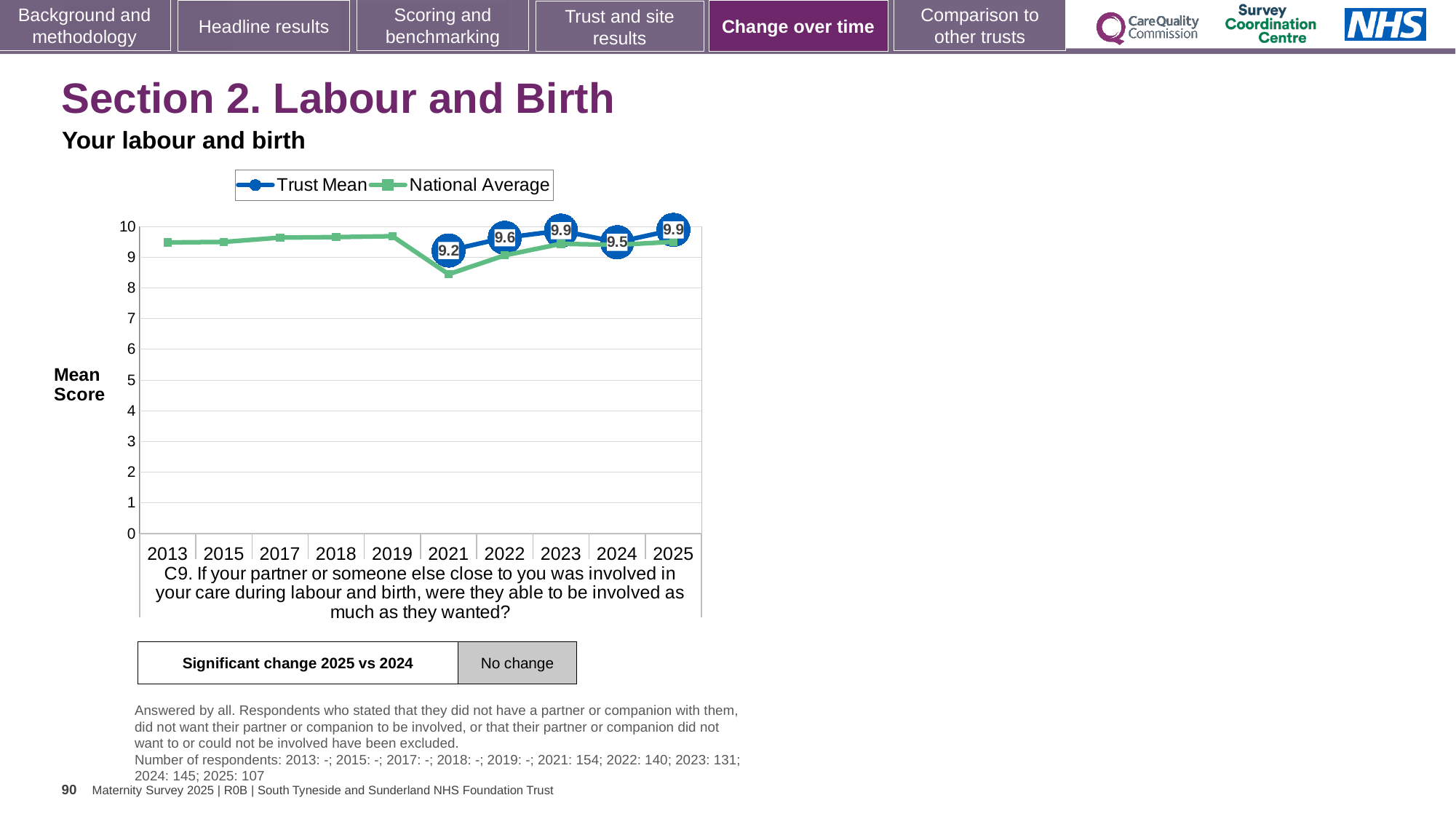
Does the Trust Mean rise or fall from 2021 to 2023? rise Which year has the larger Trust Mean, 2023 or 2024? 2023 How many years are shown on the x axis? 10 How many series does the legend list? 2 Is the National Average value for 2021 greater or less than 9? less What is the Trust Mean value for 2025? 9.9 What is the label on the y axis of the chart? Mean Score What is the Trust Mean value for 2021? 9.2 What is the Trust Mean value for 2024? 9.5 In which year is the Trust Mean lowest? 2021 What kind of chart is shown on the slide? line chart What is the difference between the Trust Mean in 2022 and in 2021? 0.4